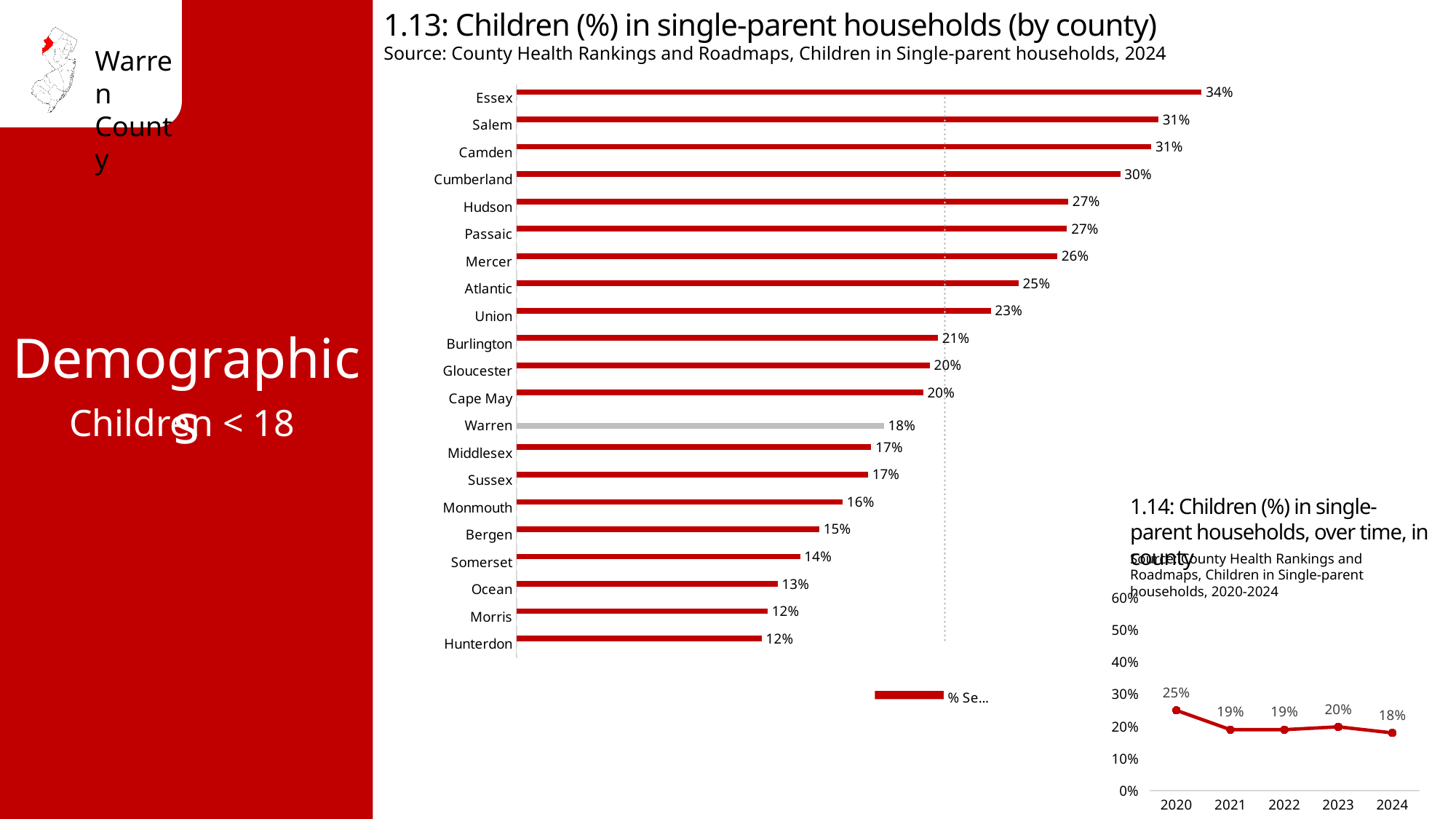
In chart 1.13 (Children (%) in single-parent households by county), how many counties are shown? 21 In chart 1.14 (Children (%) in single-parent households over time, in county), what is the value for 2020? 25% In chart 1.14 (Children (%) in single-parent households over time, in county), which year has the lowest value? 2024 In chart 1.13 (Children (%) in single-parent households by county), what is the value for Cumberland? 30% In chart 1.13 (Children (%) in single-parent households by county), which county's bar is coloured grey instead of red? Warren What kind of chart is chart 1.13 (Children (%) in single-parent households by county)? Bar chart In chart 1.13 (Children (%) in single-parent households by county), which county has the highest value? Essex In chart 1.14 (Children (%) in single-parent households over time, in county), do the values generally rise or fall from 2020 to 2024? Fall In chart 1.13 (Children (%) in single-parent households by county), what is the value for Warren? 18% What kind of chart is chart 1.14 (Children (%) in single-parent households over time, in county)? Line chart In chart 1.13 (Children (%) in single-parent households by county), which is larger, the value for Union or the value for Monmouth? Union In chart 1.13 (Children (%) in single-parent households by county), what is the difference between Essex and Warren? 16%